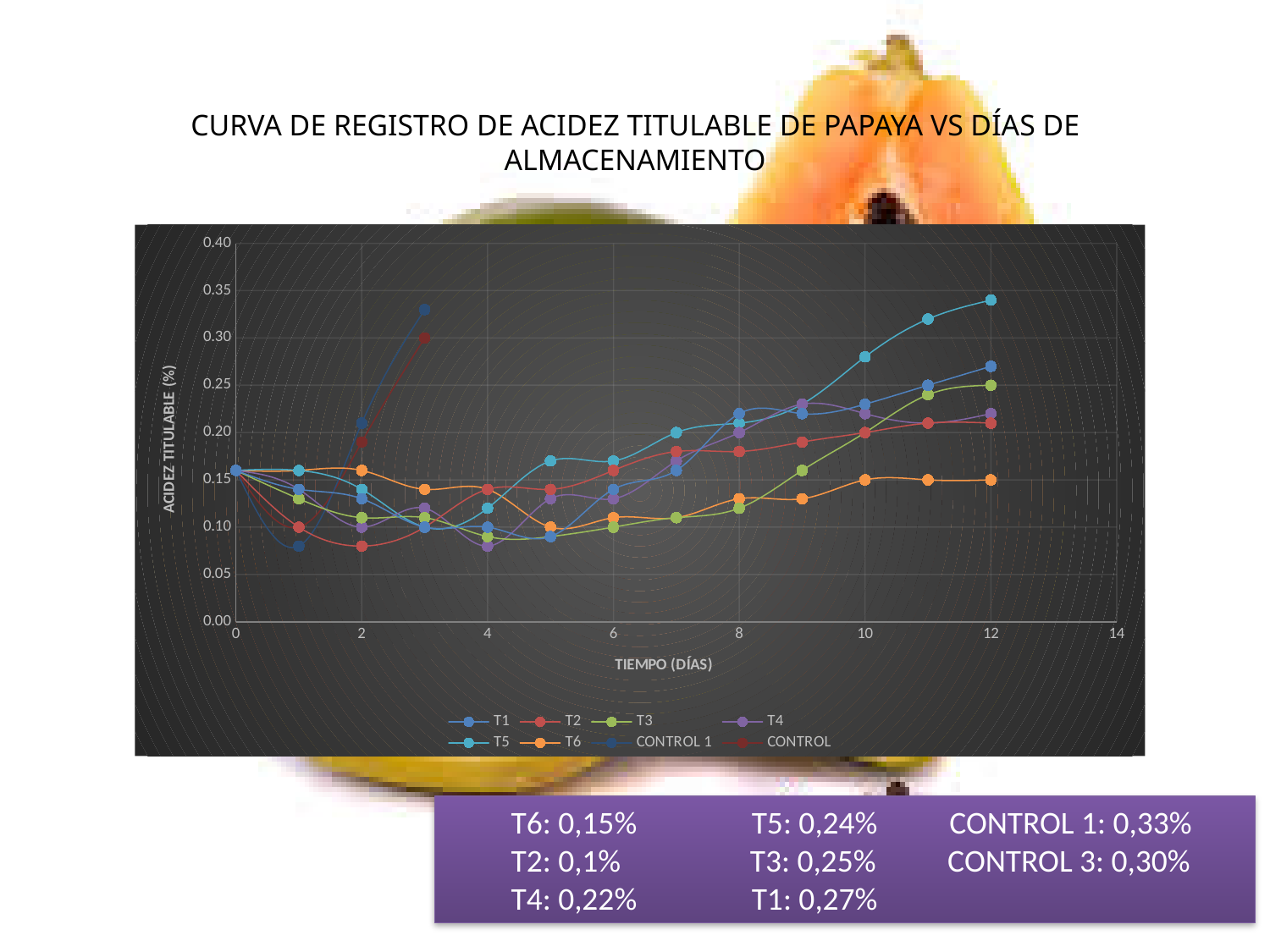
Which series has the highest value at day 12? T5 Does the T5 series rise or fall between day 4 and day 12? rise What is the label of the y axis? ACIDEZ TITULABLE (%) Is the value for CONTROL 1 at day 3 greater or less than 0.30? greater What is the label of the x axis? TIEMPO (DÍAS) How many series does the chart legend list? 8 Is the value for T6 at day 12 greater or less than 0.20? less At day 12, which series has the larger value, T5 or T6? T5 Which series has the lowest value at day 12? T6 Is the value for T3 at day 6 greater or less than 0.15? less What kind of chart is shown on the slide? line chart